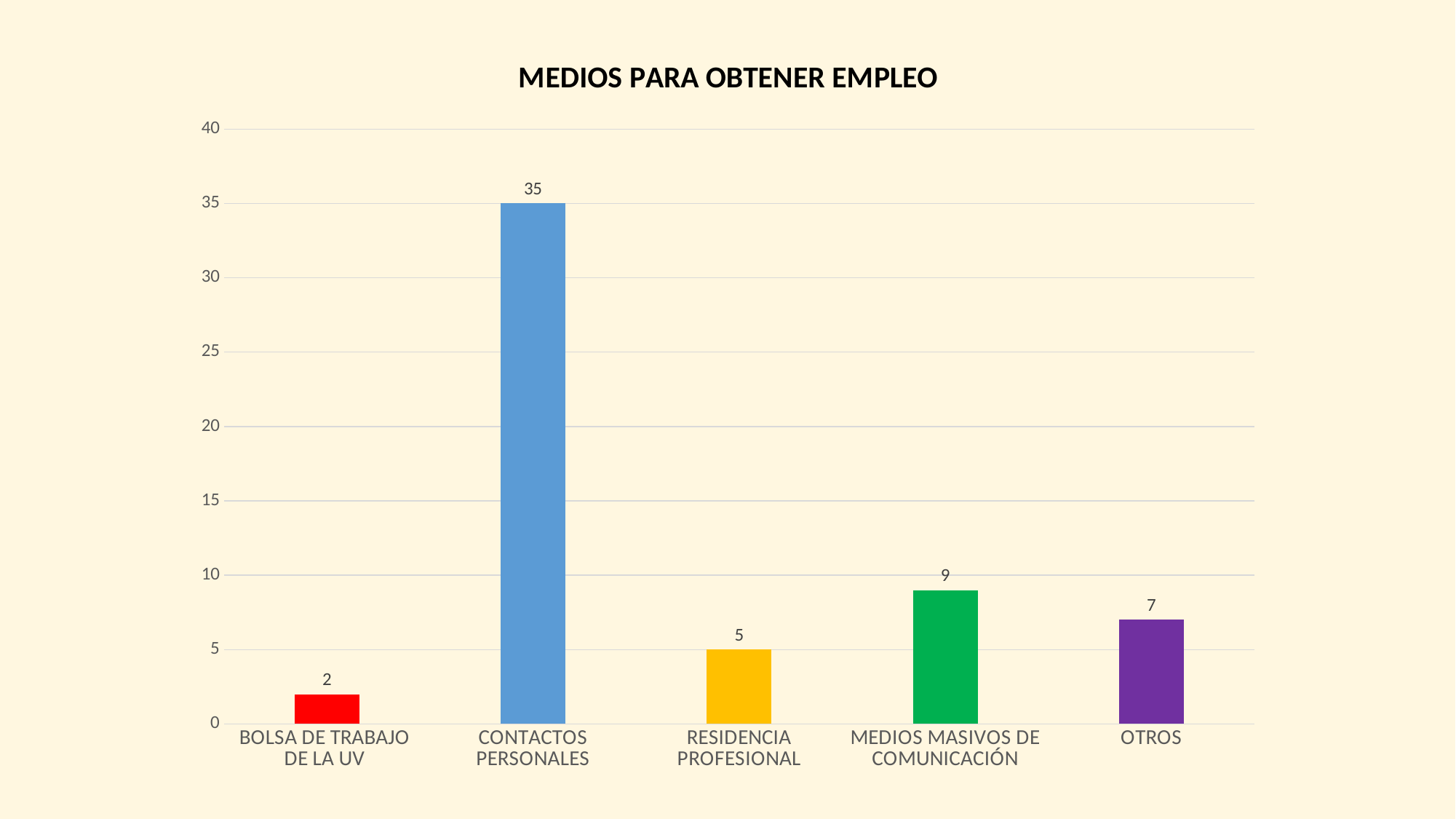
What kind of chart is shown on the slide? bar chart Which category has the highest value? CONTACTOS PERSONALES Which is larger, the value for RESIDENCIA PROFESIONAL or the value for OTROS? OTROS What is the value for BOLSA DE TRABAJO DE LA UV? 2 Which category has the lowest value? BOLSA DE TRABAJO DE LA UV What is the value for CONTACTOS PERSONALES? 35 How many categories are shown on the chart? 5 What is the value for MEDIOS MASIVOS DE COMUNICACIÓN? 9 What is the title of the chart? MEDIOS PARA OBTENER EMPLEO What is the value for OTROS? 7 What is the difference between the values for CONTACTOS PERSONALES and MEDIOS MASIVOS DE COMUNICACIÓN? 26 Is the value for MEDIOS MASIVOS DE COMUNICACIÓN greater or less than 10? less